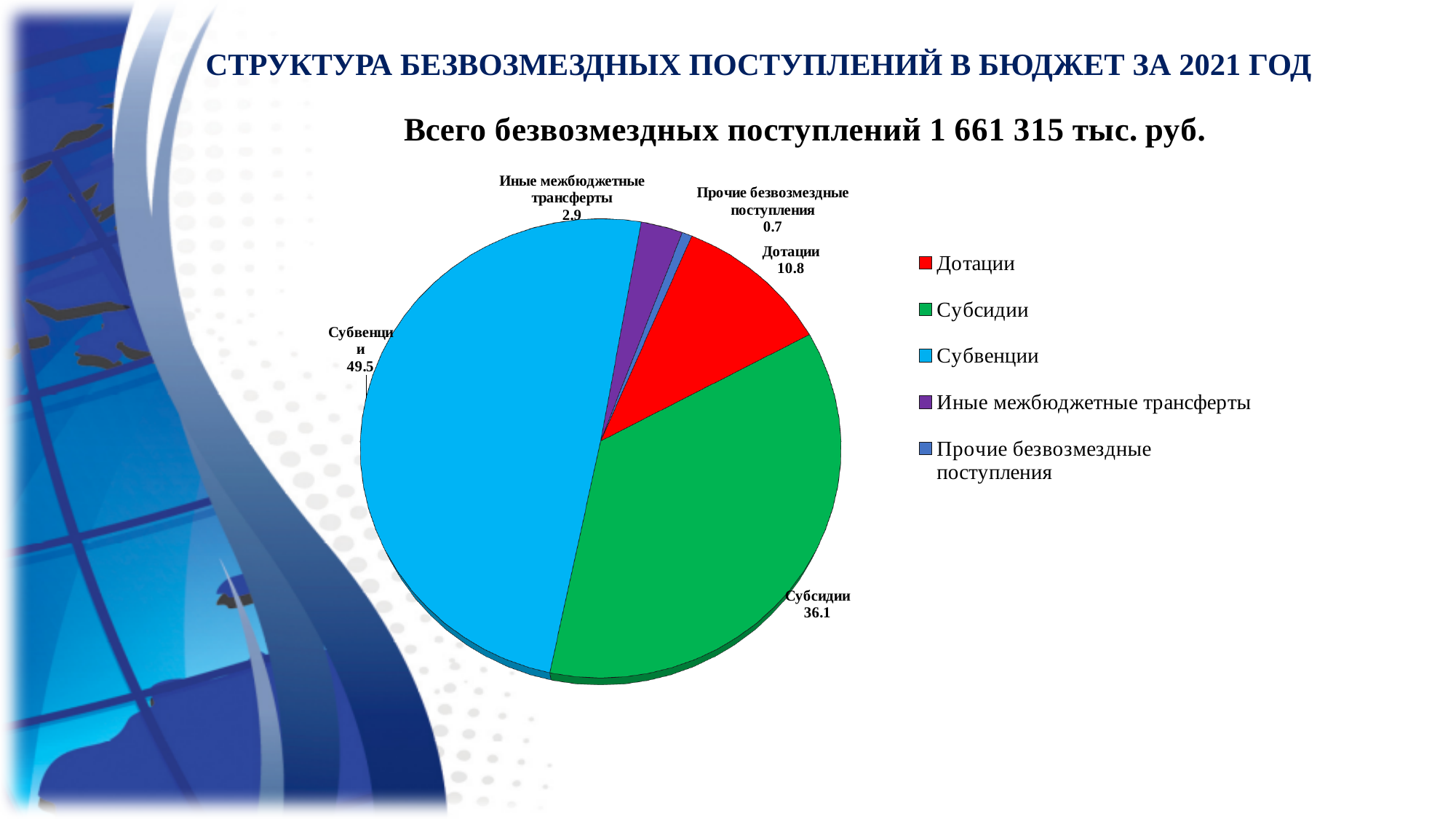
How many categories does the legend list? 5 What type of chart is shown on the slide? Pie chart What is the value shown for Иные межбюджетные трансферты? 2.9 Which category has the smallest slice of the pie? Прочие безвозмездные поступления What is the value shown for Прочие безвозмездные поступления? 0.7 What is the difference between the values for Субвенции and Субсидии? 13.4 What is the value shown for Дотации? 10.8 What is the value shown for Субсидии? 36.1 Which is larger, the value for Дотации or the value for Иные межбюджетные трансферты? Дотации What is the value shown for Субвенции? 49.5 What total amount of gratuitous receipts is stated above the chart? 1 661 315 тыс. руб. Which category has the largest slice of the pie? Субвенции